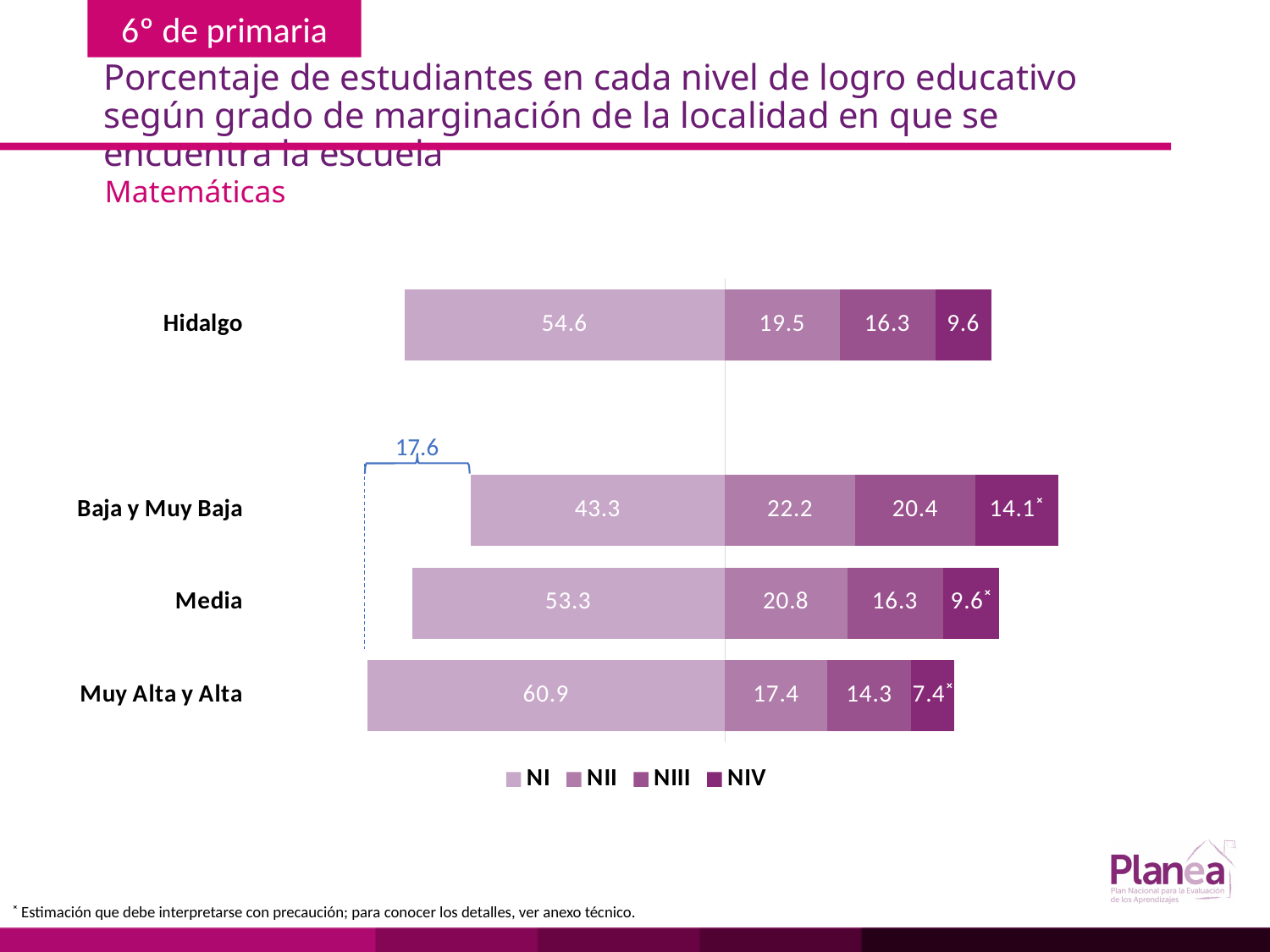
Which category has the highest NI value? Muy Alta y Alta What is the total of the stacked bar for Media? 100.0 What type of chart is shown on the slide? Stacked bar chart How many series does the legend list? 4 Which is larger, the NII value for Baja y Muy Baja or the NII value for Hidalgo? Baja y Muy Baja What is the difference between the NI value for Muy Alta y Alta and the NI value for Baja y Muy Baja? 17.6 What is the NI value for Hidalgo? 54.6 What is the NIV value for Baja y Muy Baja? 14.1 What is the NIII value for Muy Alta y Alta? 14.3 Which category has the lowest NIV value? Muy Alta y Alta How many categories (bars) are shown in the chart? 4 What is the NII value for Media? 20.8